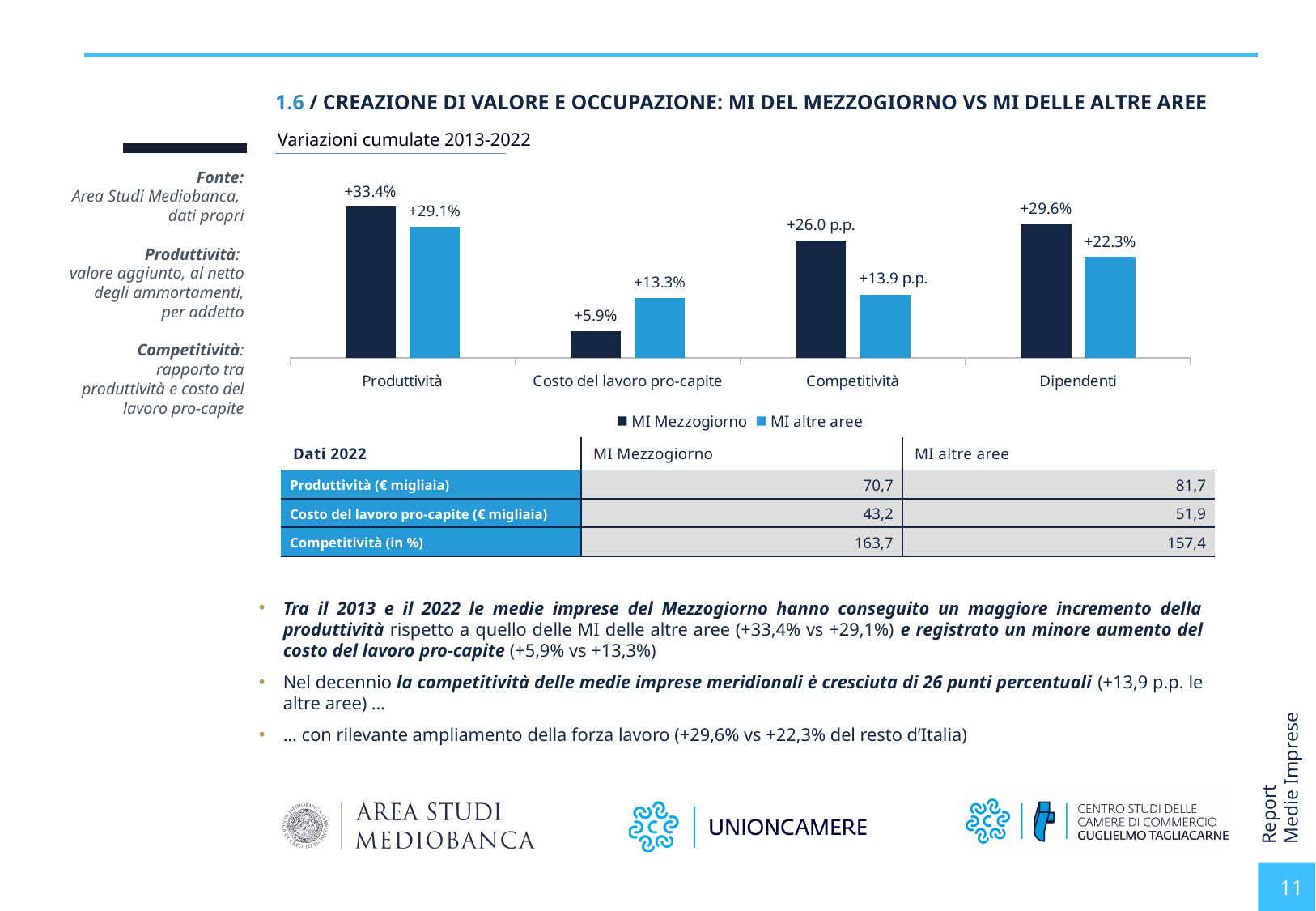
What is the value for MI Mezzogiorno in the Produttività category? +33.4% What is the value for MI altre aree in the Dipendenti category? +22.3% How many series does the chart legend list? 2 Which category has the lowest value for MI altre aree? Costo del lavoro pro-capite What type of chart is shown on the slide? Bar chart What is the subtitle shown above the chart? Variazioni cumulate 2013-2022 How many categories are shown on the x axis of the chart? 4 In the Costo del lavoro pro-capite category, which series has the larger value, MI Mezzogiorno or MI altre aree? MI altre aree What is the difference between the MI Mezzogiorno and MI altre aree values in the Competitività category? 12.1 p.p. Which category has the highest value for MI Mezzogiorno? Produttività What is the value for MI altre aree in the Costo del lavoro pro-capite category? +13.3% What is the value for MI Mezzogiorno in the Competitività category? +26.0 p.p.